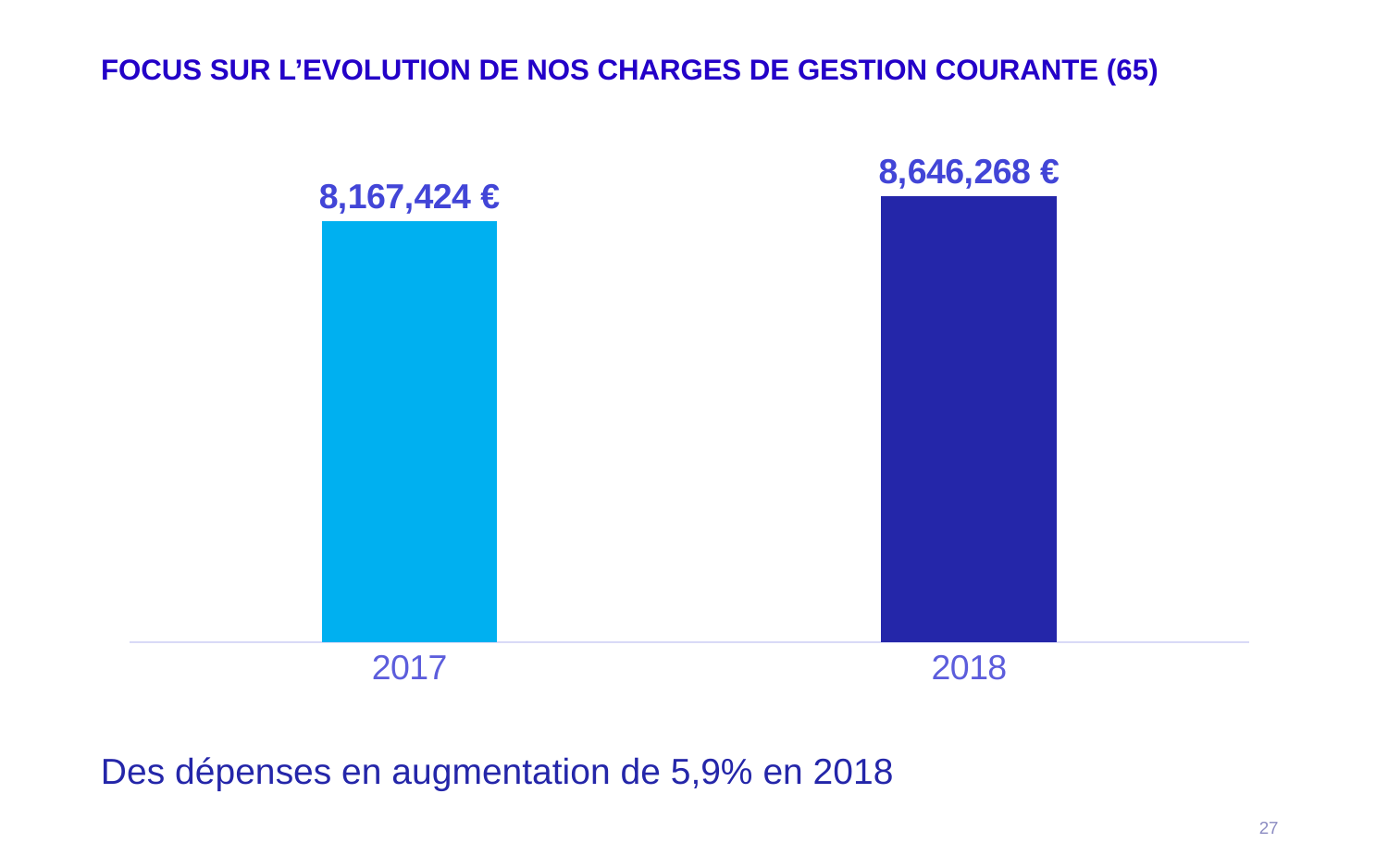
What is the value for 2017? 8,167,424 € What is the value for 2018? 8,646,268 € Do the values rise or fall from 2017 to 2018? Rise Which year has the higher value? 2018 Is the value for 2018 larger than the value for 2017? Yes What colour is the bar for 2017? Light blue What kind of chart is shown on the slide? Bar chart What is the total of the two bars? 16,813,692 € How many bars are shown in the chart? 2 Which year has the lower value? 2017 According to the text below the chart, by what percentage did expenses increase in 2018? 5,9% What is the difference between the 2018 and 2017 values? 478,844 €